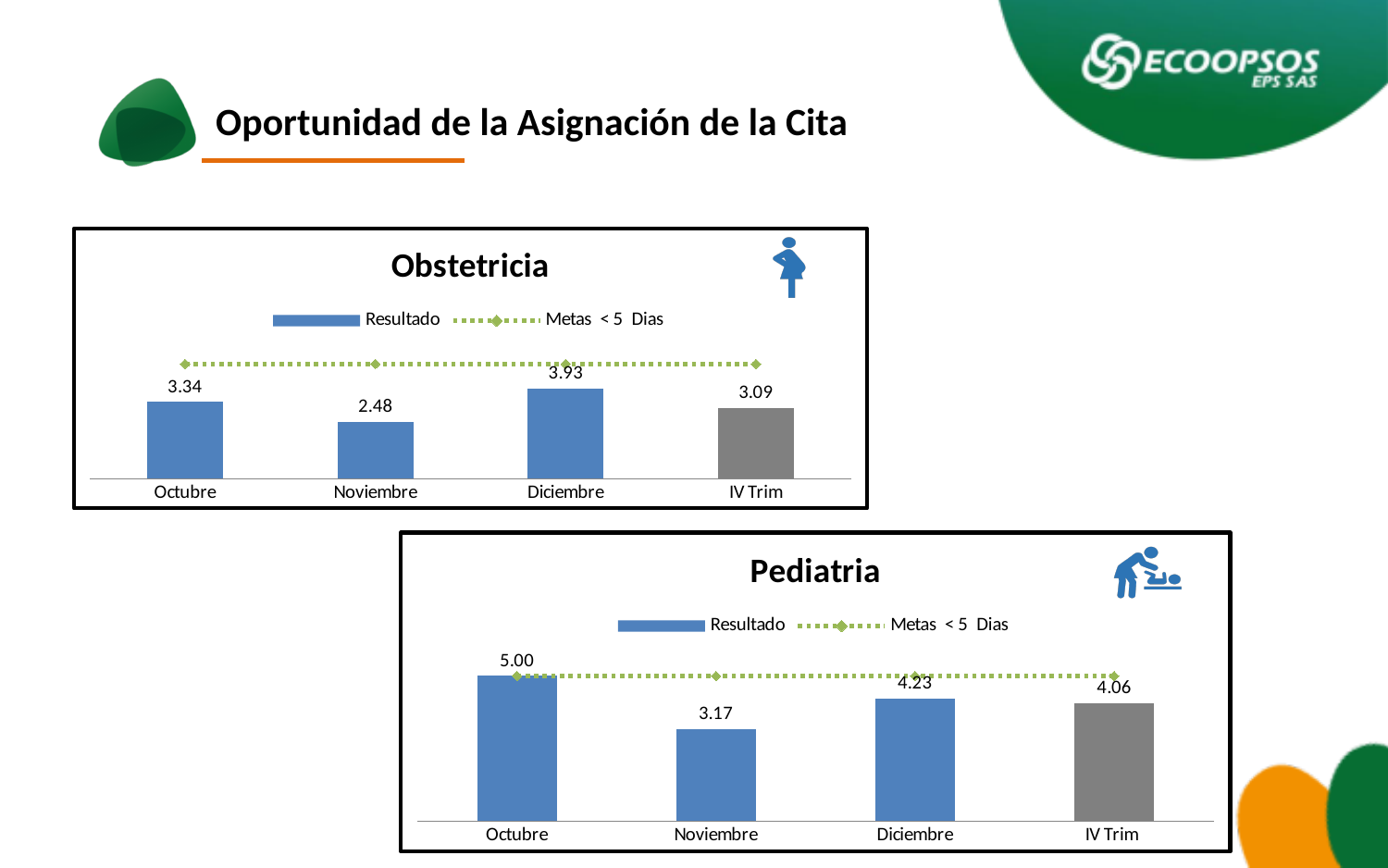
In the Obstetricia chart, which month has the highest Resultado value? Diciembre In the Obstetricia chart, what is the value for IV Trim? 3.09 In the Pediatria chart, what is the difference between the Octubre and IV Trim values? 0.94 In the Obstetricia chart, what is the difference between the Diciembre and Noviembre values? 1.45 What type of chart is the Obstetricia chart? Combination bar and line chart In the Pediatria chart, what is the value for Diciembre? 4.23 In the Obstetricia chart, what is the Resultado value for Noviembre? 2.48 In the Pediatria chart, is the value for Octubre or Diciembre larger? Octubre How many series does the legend of the Pediatria chart list? 2 In the Obstetricia chart, which month has the lowest Resultado value? Noviembre In the Pediatria chart, what is the Resultado value for Octubre? 5.00 In the Pediatria chart, which month has the lowest Resultado value? Noviembre